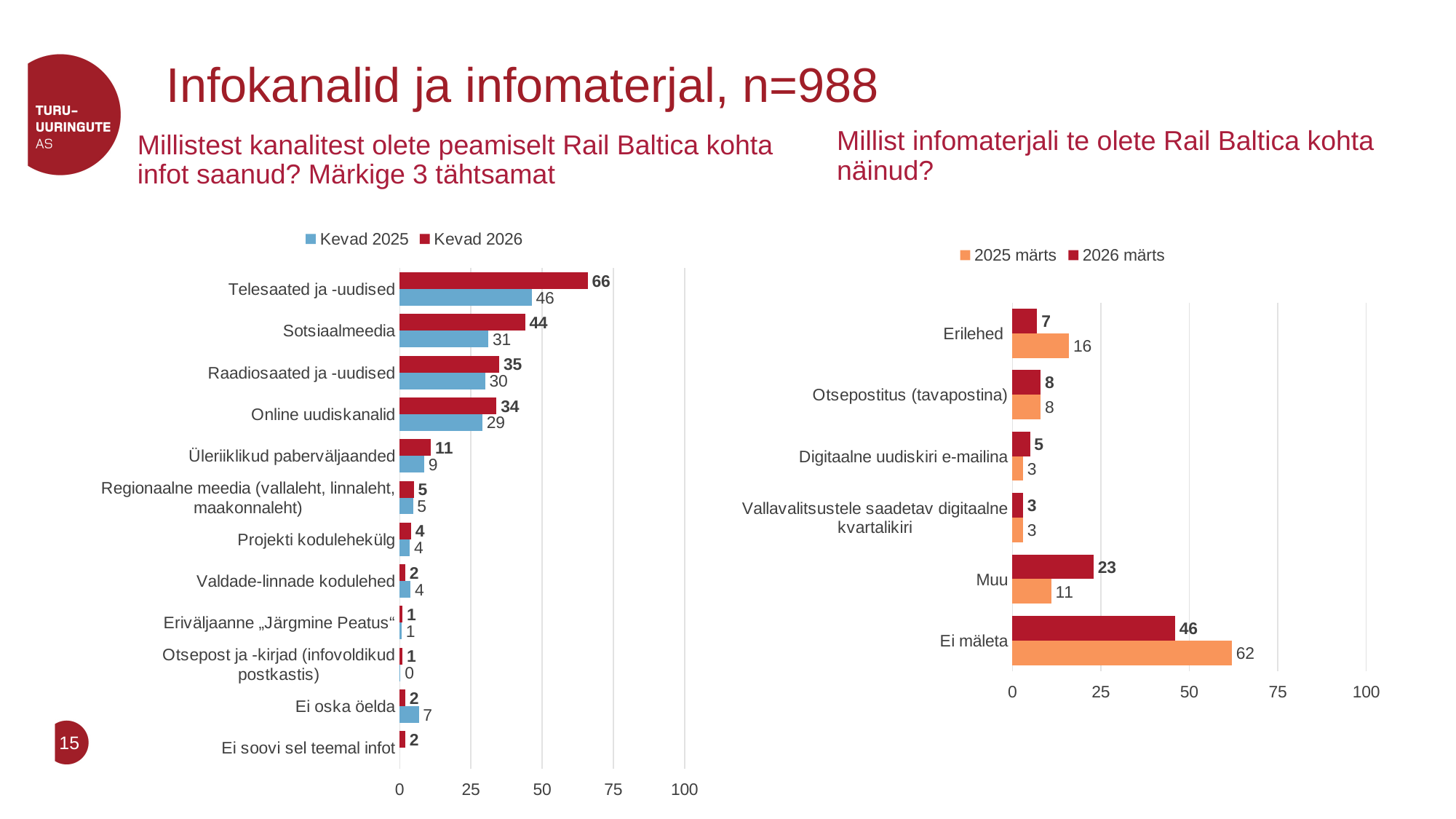
In the left chart, which is larger for Ei oska öelda: the Kevad 2025 value or the Kevad 2026 value? Kevad 2025 In the right chart, how many categories are shown? 6 In the left chart, what is the Kevad 2025 value for Sotsiaalmeedia? 31 In the left chart, how many categories are shown on the vertical axis? 12 In the left chart (Millistest kanalitest olete peamiselt Rail Baltica kohta infot saanud?), what is the Kevad 2026 value for Telesaated ja -uudised? 66 In the left chart, what is the difference between the Kevad 2026 and Kevad 2025 values for Telesaated ja -uudised? 20 In the right chart, what is the 2026 märts value for Muu? 23 In the right chart (Millist infomaterjali te olete Rail Baltica kohta näinud?), what is the 2025 märts value for Ei mäleta? 62 What type of chart is the right chart? Bar chart In the left chart, which category has the highest Kevad 2026 value? Telesaated ja -uudised In the left chart, how many series does the legend list? 2 In the right chart, what is the difference between the 2025 märts and 2026 märts values for Erilehed? 9